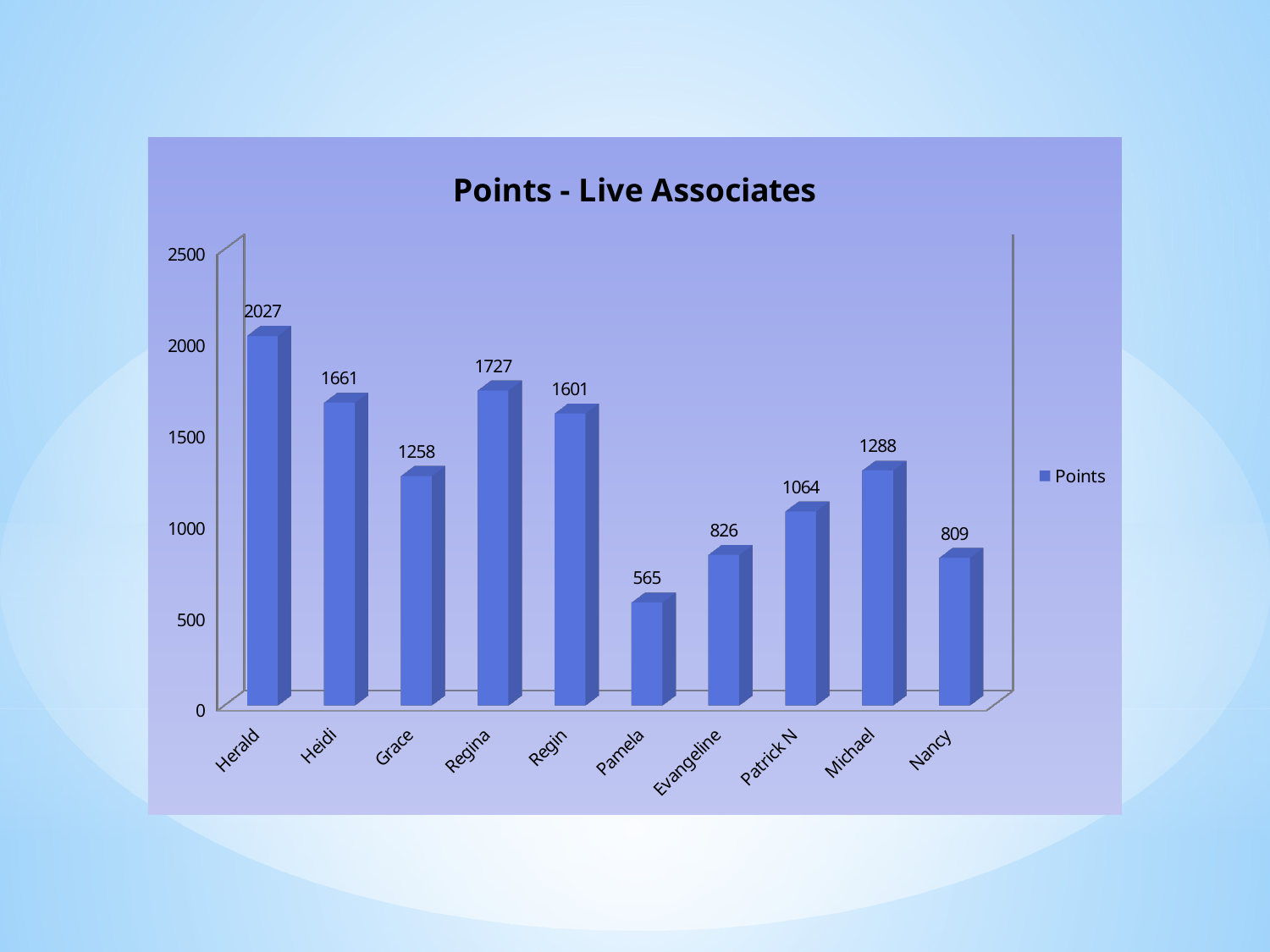
How many associates are shown on the x axis? 10 What is the value for Herald? 2027 How many series does the legend list? 1 What is the value for Pamela? 565 What is the difference between the values for Regina and Regin? 126 Is the value for Evangeline greater or less than 1000? less Which associate has the highest points? Herald What kind of chart is shown? bar chart What is the title of the chart? Points - Live Associates Which is larger, the value for Michael or the value for Grace? Michael What is the value for Patrick N? 1064 Which associate has the lowest points? Pamela